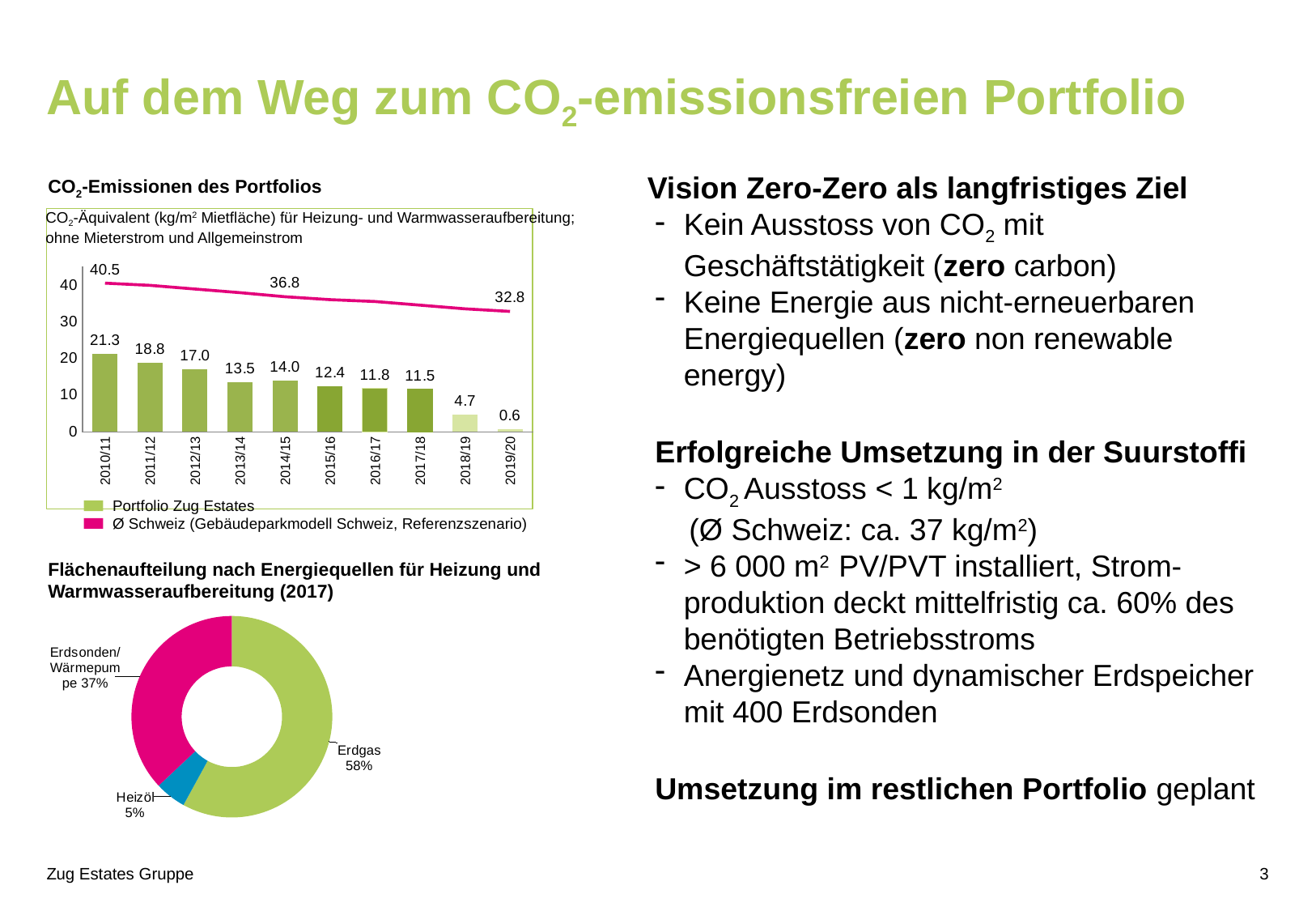
In the Flächenaufteilung nach Energiequellen chart, which energy source has the smallest share? Heizöl In the CO2-Emissionen des Portfolios chart, which year has the highest Portfolio Zug Estates value? 2010/11 In the CO2-Emissionen des Portfolios chart, which year has the lowest Portfolio Zug Estates value? 2019/20 In the CO2-Emissionen des Portfolios chart, do the Portfolio Zug Estates values generally rise or fall from 2010/11 to 2019/20? fall In the CO2-Emissionen des Portfolios chart, what is the Portfolio Zug Estates value for 2010/11? 21.3 In the CO2-Emissionen des Portfolios chart, how many years are shown on the x axis? 10 In the CO2-Emissionen des Portfolios chart, what is the difference between the Portfolio Zug Estates values for 2017/18 and 2018/19? 6.8 In the CO2-Emissionen des Portfolios chart, what is the Ø Schweiz value shown for 2014/15? 36.8 In the CO2-Emissionen des Portfolios chart, is the Portfolio Zug Estates value for 2013/14 or 2014/15 larger? 2014/15 In the CO2-Emissionen des Portfolios chart, how many series does the legend list? 2 In the Flächenaufteilung nach Energiequellen chart, what share does Erdgas have? 58% In the CO2-Emissionen des Portfolios chart, what is the Portfolio Zug Estates value for 2019/20? 0.6